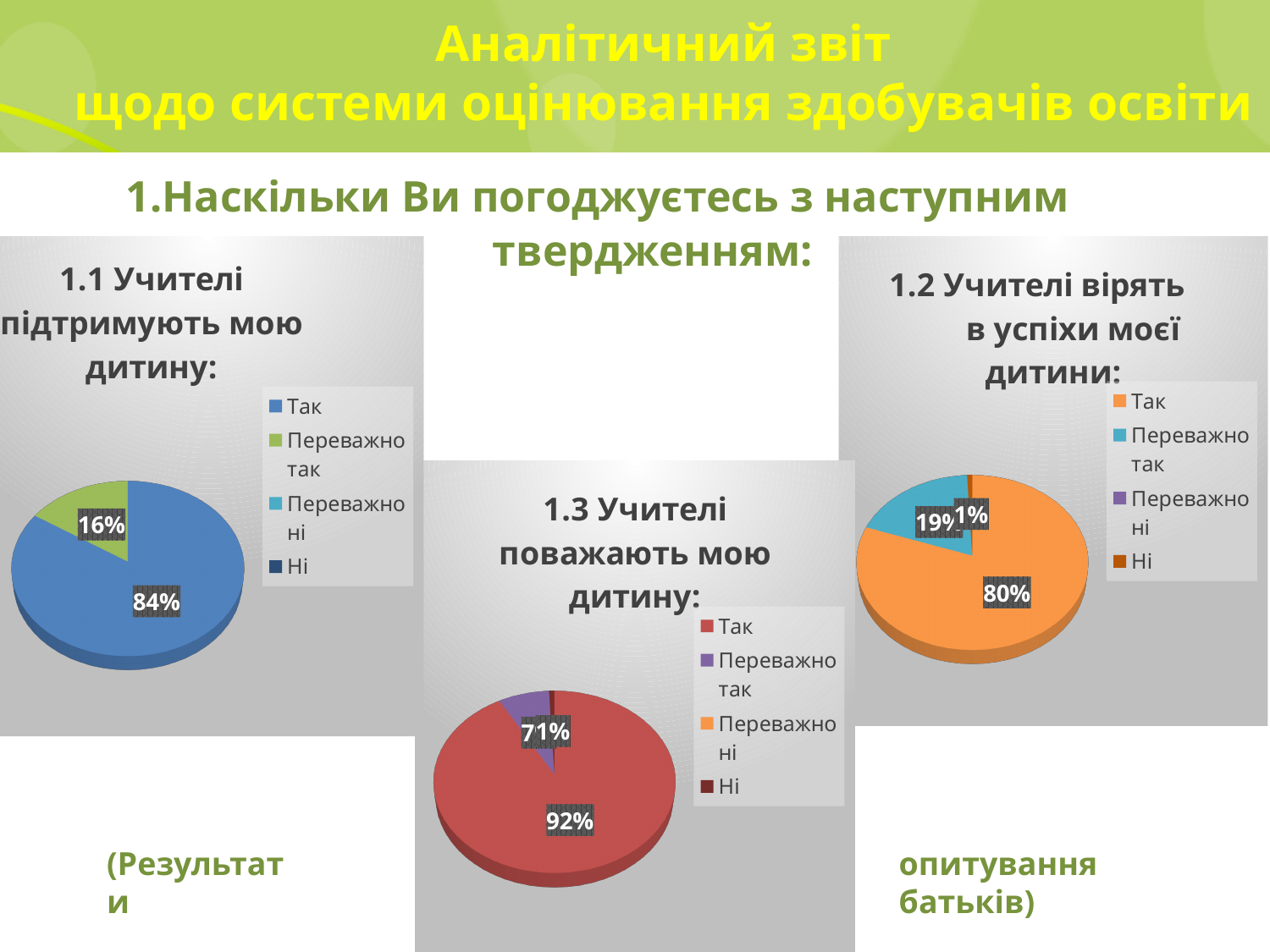
In the chart '1.1 Учителі підтримують мою дитину', what percentage is shown for 'Переважно так'? 16% In the chart '1.2 Учителі вірять в успіхи моєї дитини', what percentage is shown for 'Переважно так'? 19% In the chart '1.2 Учителі вірять в успіхи моєї дитини', which is larger: 'Так' or 'Переважно так'? Так In the chart '1.1 Учителі підтримують мою дитину', what percentage is shown for 'Так'? 84% How many pie charts are shown on the slide? 3 How many entries does the legend of the chart '1.3 Учителі поважають мою дитину' list? 4 What type of chart is '1.2 Учителі вірять в успіхи моєї дитини'? Pie chart In the chart '1.3 Учителі поважають мою дитину', what percentage is shown for 'Так'? 92% In the chart '1.1 Учителі підтримують мою дитину', which category has the largest slice? Так In the chart '1.2 Учителі вірять в успіхи моєї дитини', what percentage is shown for 'Так'? 80% In the chart '1.3 Учителі поважають мою дитину', which category has the largest slice? Так In the chart '1.1 Учителі підтримують мою дитину', what is the difference in percentage points between 'Так' and 'Переважно так'? 68